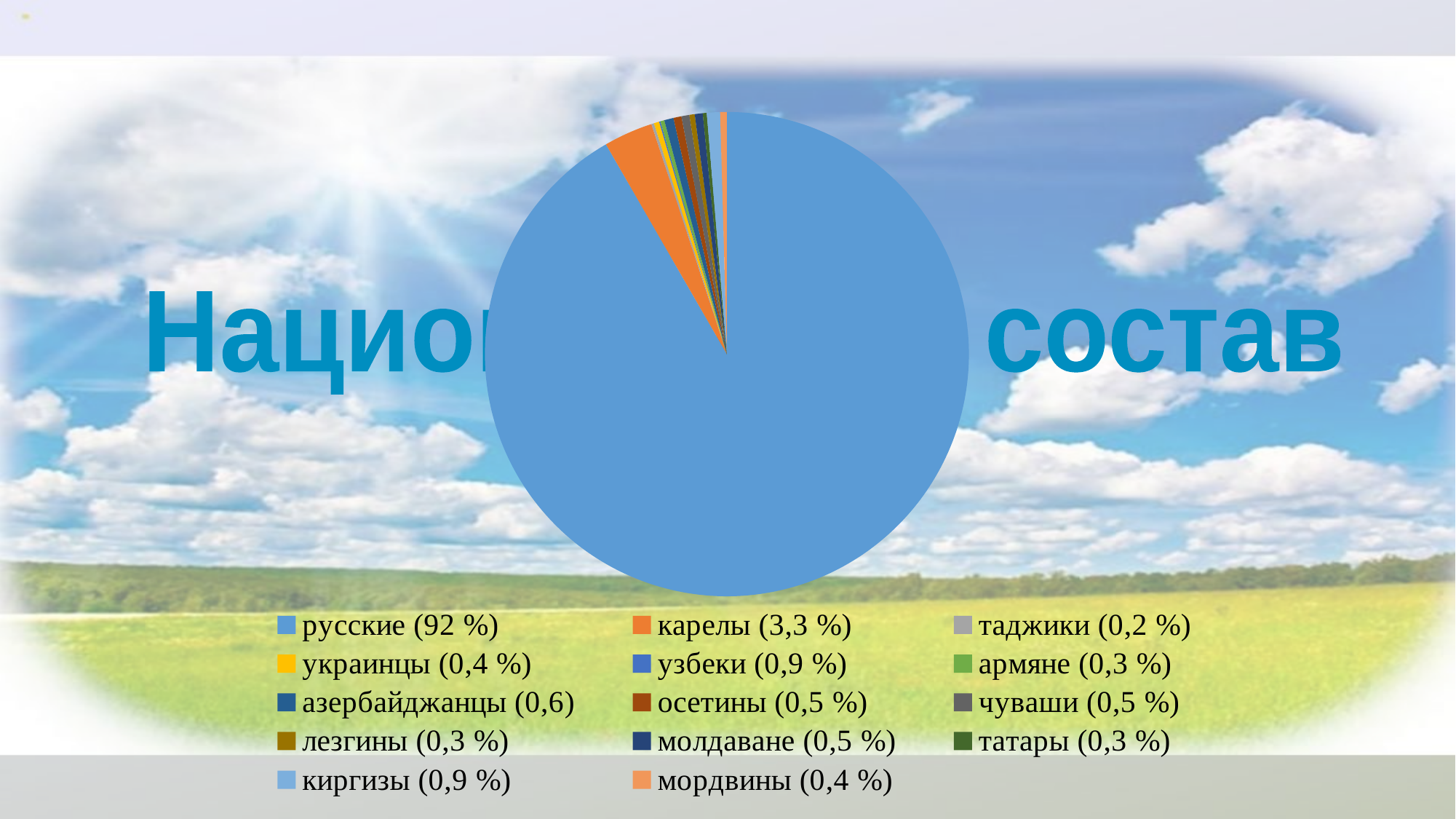
Which category has the largest slice of the pie chart? русские Which has a larger share, карелы or узбеки? карелы What is the difference between the percentages for русские and карелы? 88,7 % What kind of chart is shown on the slide? pie chart What percentage is shown for карелы in the legend? 3,3 % What percentage is shown for азербайджанцы in the legend? 0,6 What percentage is shown for таджики in the legend? 0,2 % How many categories does the legend of the pie chart list? 14 What percentage is shown for узбеки in the legend? 0,9 % What share of the pie does the русские slice represent? 92 % What colour is the slice for русские in the pie chart? blue